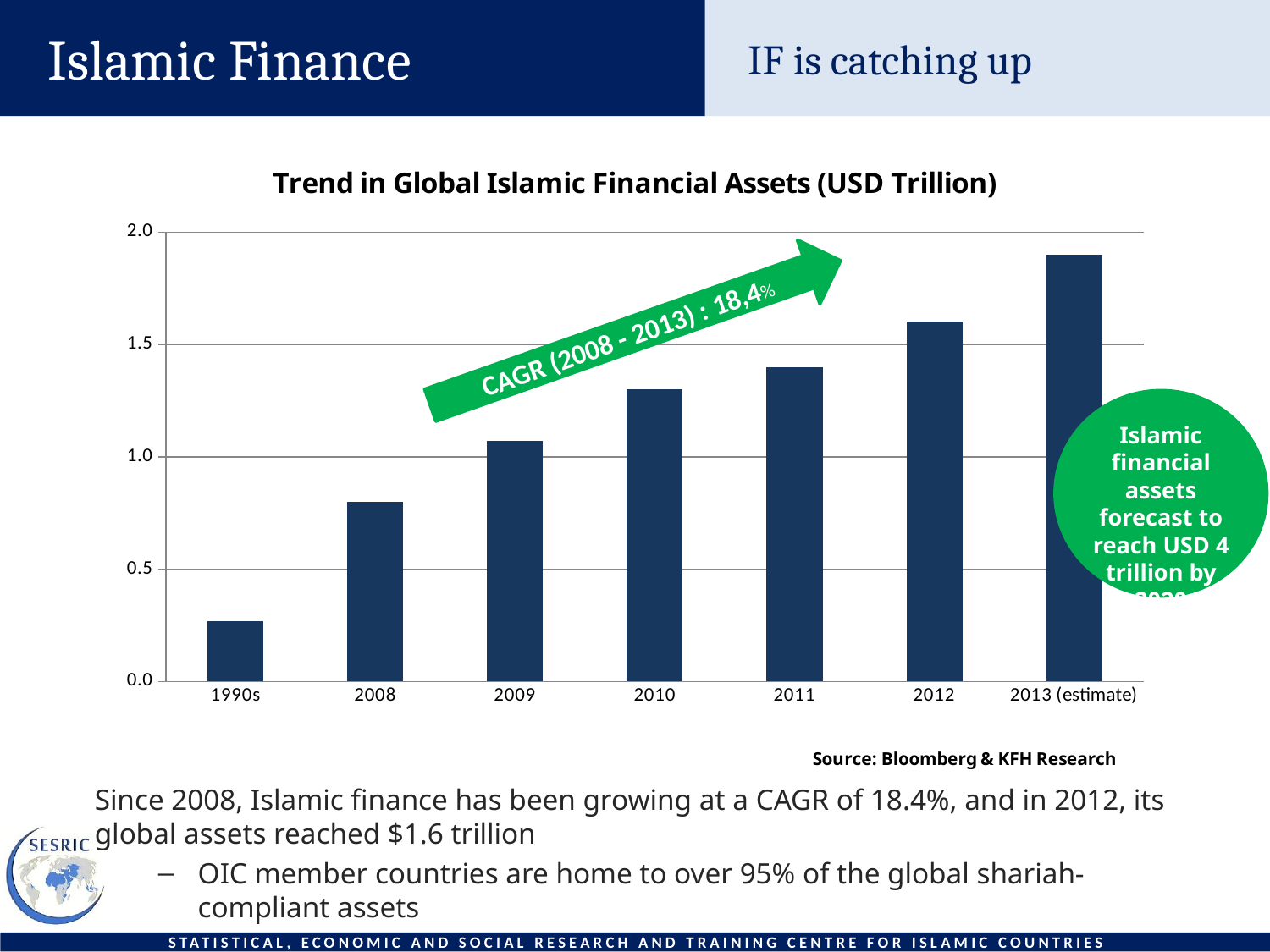
What is the title of the chart? Trend in Global Islamic Financial Assets (USD Trillion) Which category has the lowest bar in the chart? 1990s Is the value for 2013 (estimate) greater or less than 2.0? less What CAGR for 2008 - 2013 is annotated on the chart? 18,4% Which is larger, the value for 2012 or the value for 2009? 2012 Do the values rise or fall from 1990s to 2013 (estimate) along the x axis? rise How many categories are shown on the x axis of the chart? 7 Is the value for 1990s greater or less than 0.5? less What kind of chart is shown on the slide? bar chart Is the value for 2010 greater or less than 1.0? greater Which category has the highest bar in the chart? 2013 (estimate)